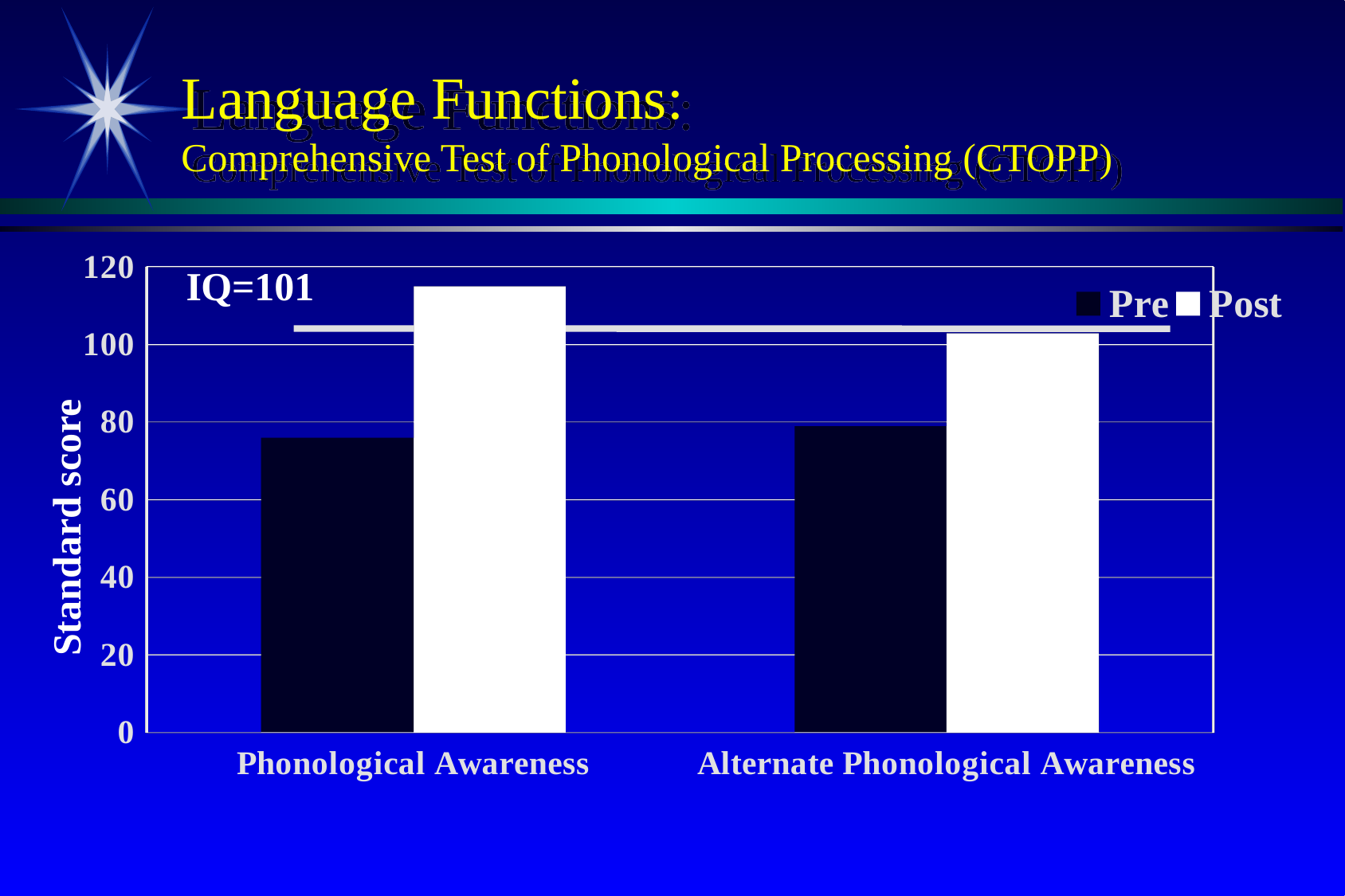
How many categories are shown on the x axis? 2 Is the Post value for Alternate Phonological Awareness greater or less than 80? greater Is the Pre value for Phonological Awareness greater or less than 80? less How many series does the legend list? 2 Which series has the higher value for Phonological Awareness, Pre or Post? Post What is the label on the y axis of the chart? Standard score Which series has the higher value for Alternate Phonological Awareness, Pre or Post? Post Is the Post value for Phonological Awareness greater or less than 100? greater Which bar is the highest in the chart? Post for Phonological Awareness What kind of chart is shown on the slide? bar chart What IQ value is annotated on the chart? IQ=101